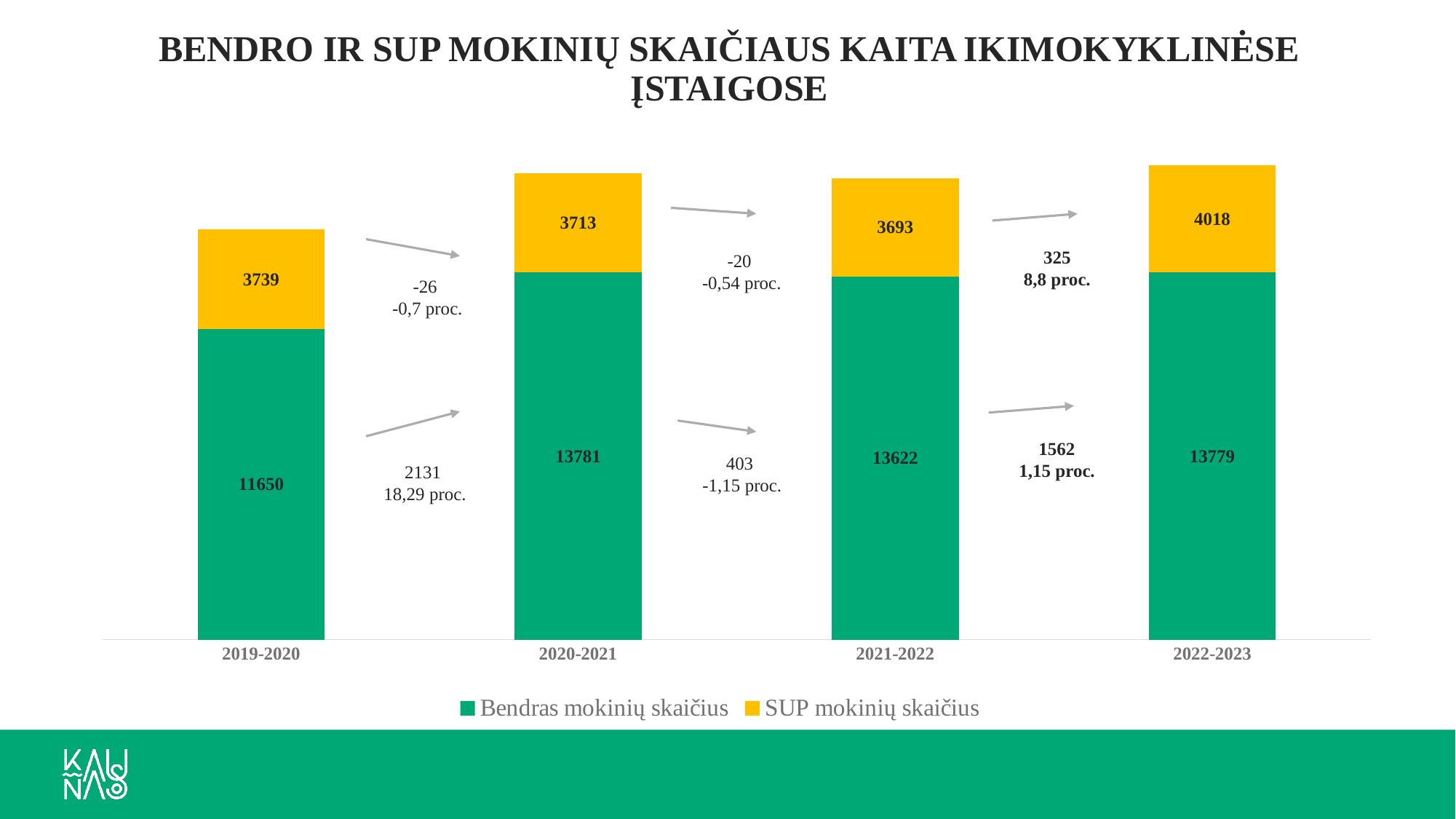
Which school year has the highest SUP mokinių skaičius? 2022-2023 What is the value of SUP mokinių skaičius for 2022-2023? 4018 What kind of chart is shown on the slide? Stacked bar chart Which school year has the lowest SUP mokinių skaičius? 2021-2022 How many series does the legend list? 2 Which school year has the lowest Bendras mokinių skaičius? 2019-2020 What is the difference between SUP mokinių skaičius in 2022-2023 and in 2021-2022? 325 How many school years are shown on the x axis? 4 What is the value of Bendras mokinių skaičius for 2019-2020? 11650 What is the value of Bendras mokinių skaičius for 2021-2022? 13622 Is SUP mokinių skaičius larger in 2019-2020 or in 2020-2021? 2019-2020 What is the total of the stacked bar for 2019-2020? 15389